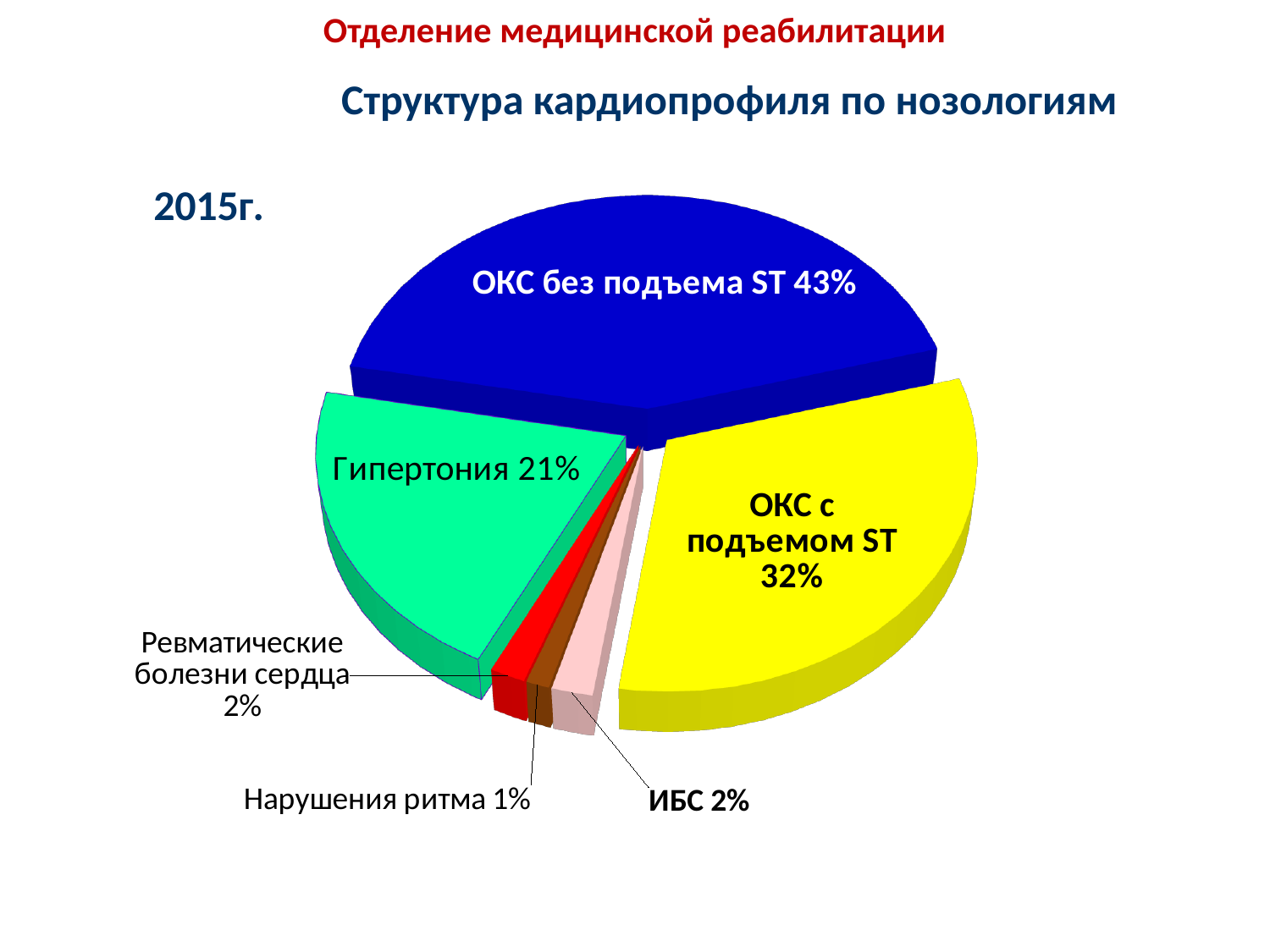
Which is larger, the share for Гипертония or the share for ОКС с подъемом ST? ОКС с подъемом ST Which category has the smallest slice of the pie? Нарушения ритма Which category has the largest slice of the pie? ОКС без подъема ST What share of the pie does ОКС с подъемом ST have? 32% What is the value shown for Ревматические болезни сердца? 2% What year is indicated next to the chart? 2015г. What is the value shown for Гипертония? 21% What is the value shown for Нарушения ритма? 1% What share of the pie does ОКС без подъема ST have? 43% What is the difference between the shares of ОКС без подъема ST and ОКС с подъемом ST? 11% How many slices does the pie chart have? 6 What kind of chart is shown on the slide? Pie chart